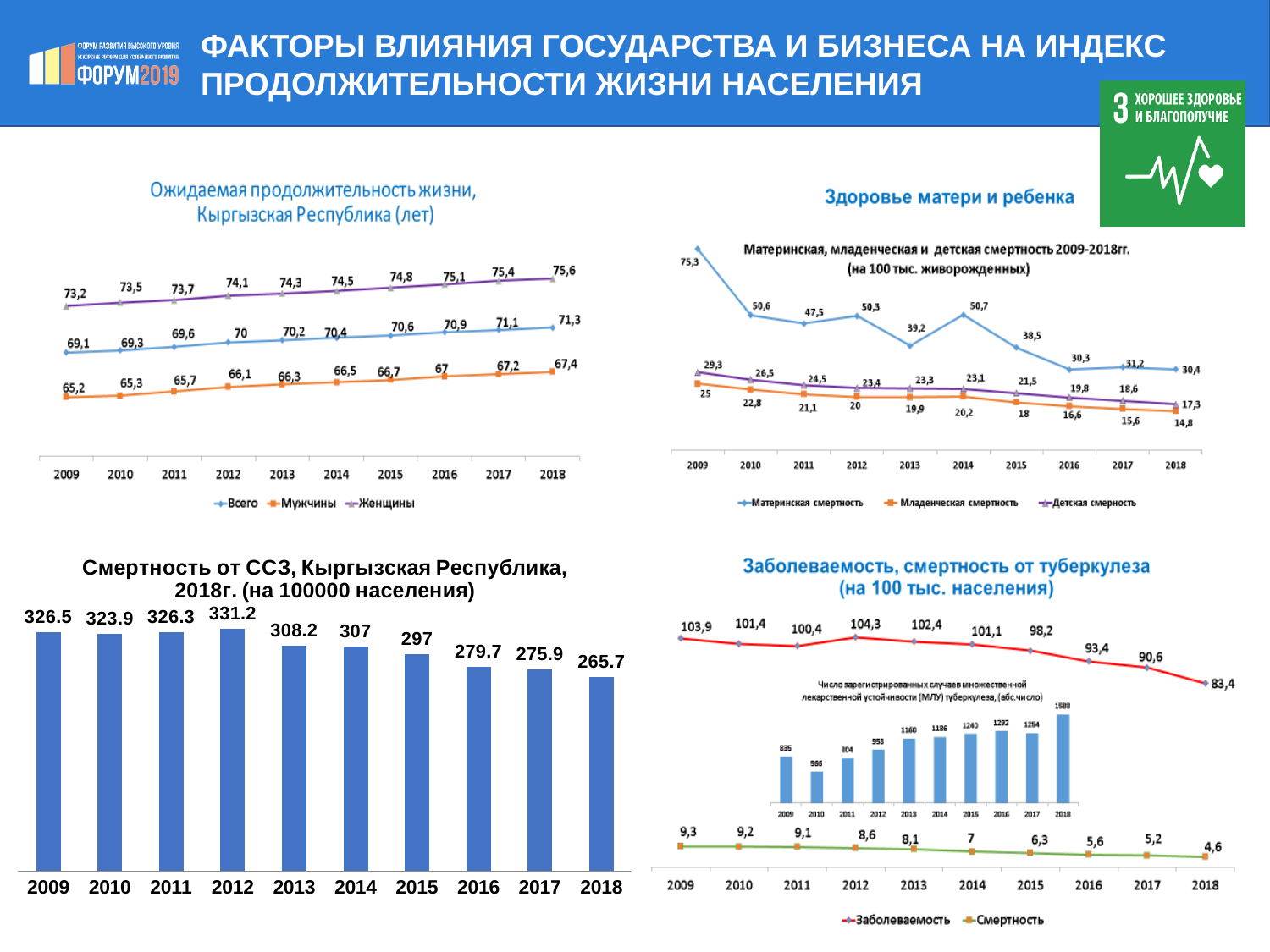
In the chart 'Заболеваемость, смертность от туберкулеза (на 100 тыс. населения)', what is the value for Заболеваемость in 2012? 104,3 In the chart 'Смертность от ССЗ, Кыргызская Республика, 2018г. (на 100000 населения)', what is the value for 2012? 331.2 In the chart 'Ожидаемая продолжительность жизни, Кыргызская Республика (лет)', how many series does the legend list? 3 In the inset bar chart inside the tuberculosis chart (Число зарегистрированных случаев МЛУ туберкулеза), which year has the highest value? 2018 In the chart 'Ожидаемая продолжительность жизни, Кыргызская Республика (лет)', do the values for Мужчины rise or fall from 2009 to 2018? rise In the chart 'Заболеваемость, смертность от туберкулеза (на 100 тыс. населения)', what is the difference between Смертность in 2009 and in 2018? 4,7 What kind of chart is 'Смертность от ССЗ, Кыргызская Республика, 2018г. (на 100000 населения)'? bar chart In the chart 'Материнская, младенческая и детская смертность 2009-2018гг.', what is the value for Материнская смертность in 2009? 75,3 In the chart 'Смертность от ССЗ, Кыргызская Республика, 2018г. (на 100000 населения)', what is the difference between the values for 2009 and 2018? 60.8 In the chart 'Ожидаемая продолжительность жизни, Кыргызская Республика (лет)', what is the value for Женщины in 2018? 75,6 In the chart 'Смертность от ССЗ, Кыргызская Республика, 2018г. (на 100000 населения)', which year has the lowest value? 2018 In the chart 'Материнская, младенческая и детская смертность 2009-2018гг.', which is larger in 2018: Младенческая смертность or Детская смертность? Детская смертность